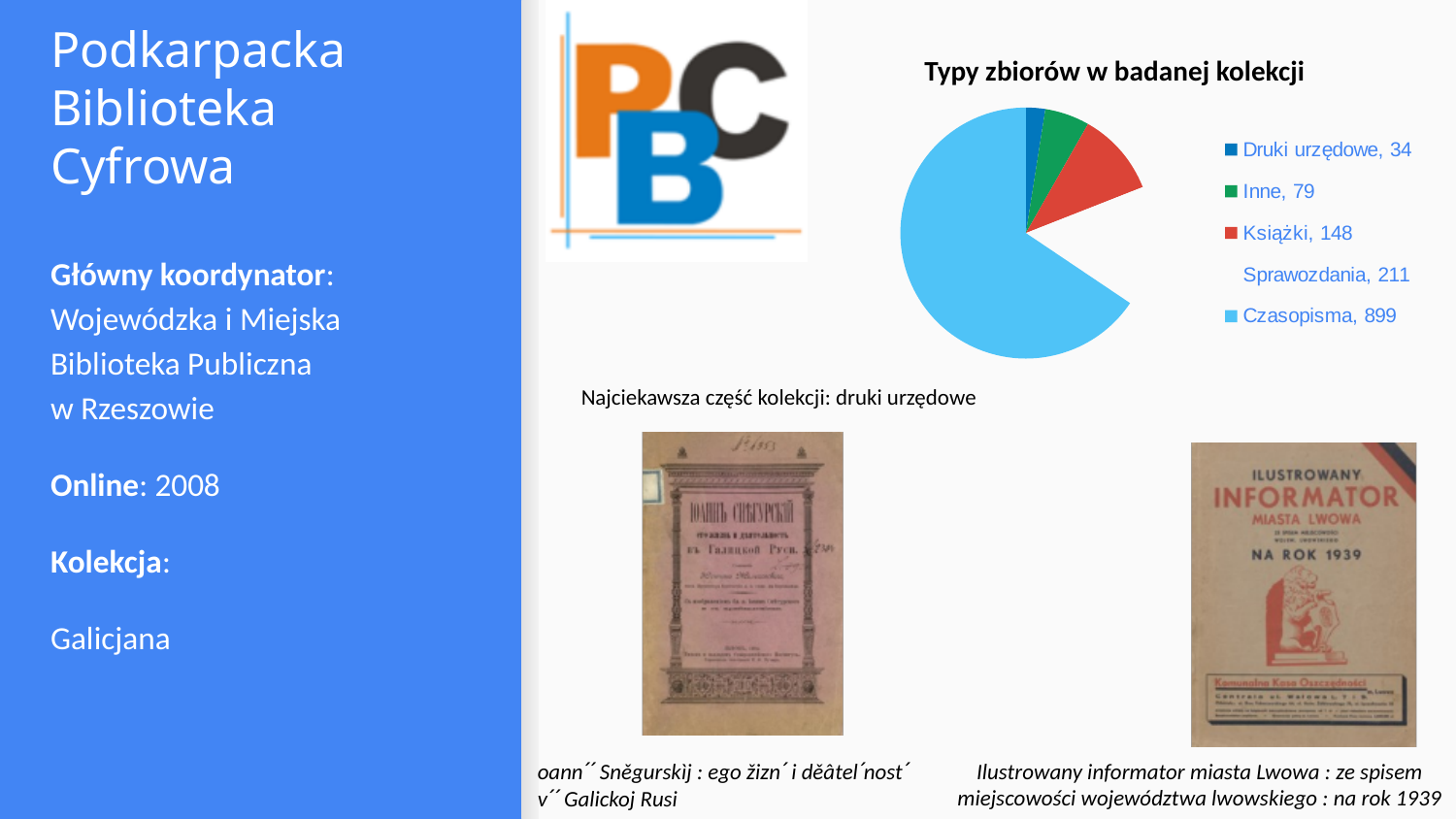
What is the value for Druki urzędowe? 34 How many categories does the chart's legend list? 5 What is the value for Sprawozdania? 211 What is the total of all the values shown in the chart's legend? 1371 Which category has the lowest value? Druki urzędowe Which category has the highest value? Czasopisma What is the value for Czasopisma? 899 What is the value for Książki? 148 What is the difference between the values for Sprawozdania and Książki? 63 What kind of chart is shown on the slide? pie chart Which is larger, the value for Inne or the value for Książki? Książki What is the title of the chart? Typy zbiorów w badanej kolekcji